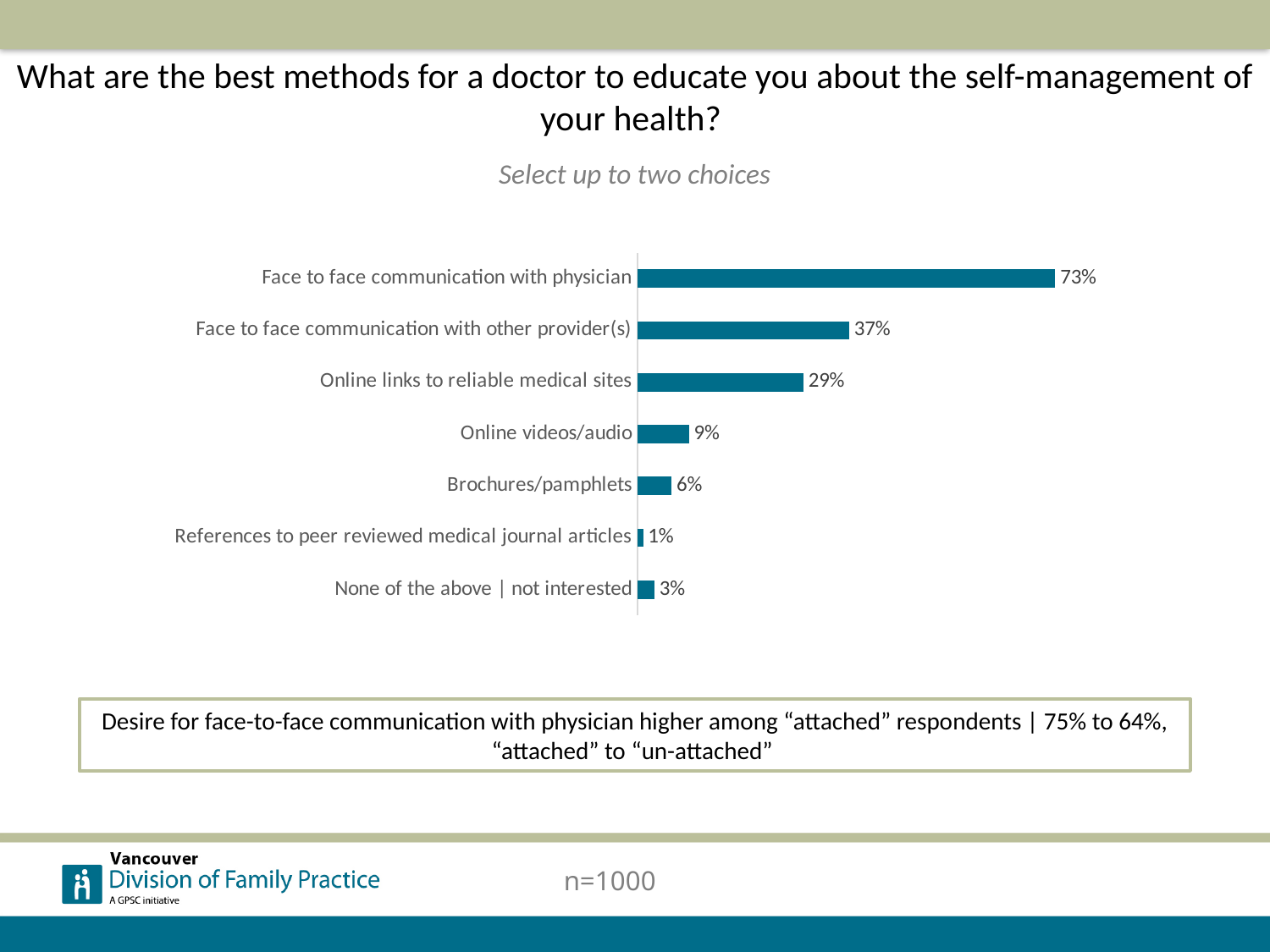
Which category has the highest value? Face to face communication with physician What is the sample size shown on the slide? n=1000 Which category has the lowest value? References to peer reviewed medical journal articles What is the difference between face to face communication with physician and face to face communication with other provider(s)? 36% What is the value for online links to reliable medical sites? 29% What percentage of respondents chose face to face communication with physician? 73% Which is larger: online links to reliable medical sites or online videos/audio? Online links to reliable medical sites What type of chart is shown on the slide? Bar chart What percentage selected brochures/pamphlets? 6% How many categories are shown in the chart? 7 Which is larger: none of the above | not interested or references to peer reviewed medical journal articles? None of the above | not interested What is the difference between online videos/audio and brochures/pamphlets? 3%